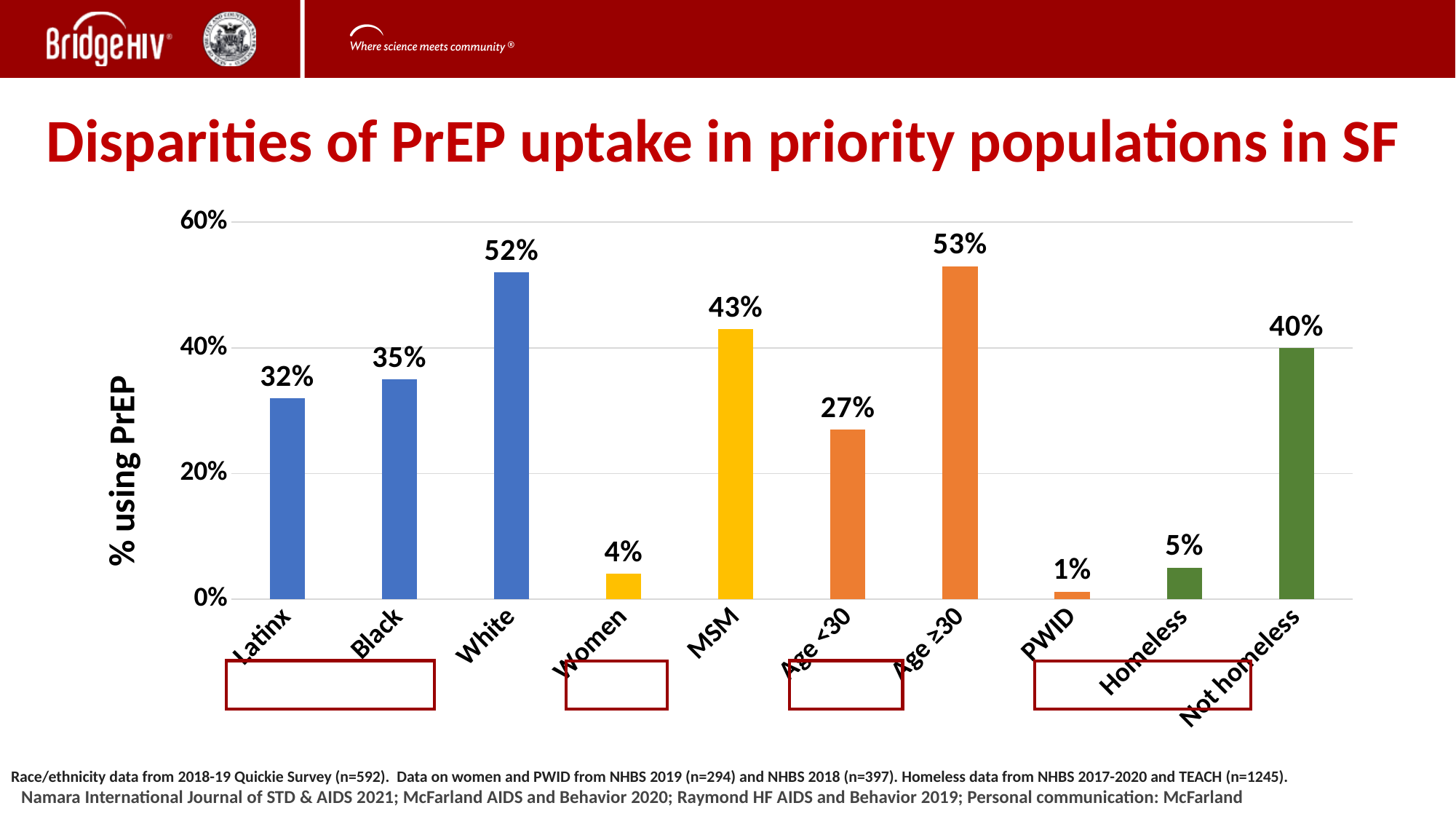
How many categories are shown on the x axis of the chart? 10 What kind of chart is shown on the slide? bar chart Which has a higher % using PrEP, MSM or Black? MSM What is the label of the y axis of the chart? % using PrEP Which category has the highest % using PrEP? Age ≥30 Which category has the lowest % using PrEP? PWID What is the difference in % using PrEP between White and Latinx? 20% What is the value for PWID in the chart? 1% What is the value for Women in the chart? 4% What is the difference in % using PrEP between Not homeless and Homeless? 35% What percentage of White individuals are using PrEP according to the chart? 52% Is the value for Age <30 greater or less than 20%? greater